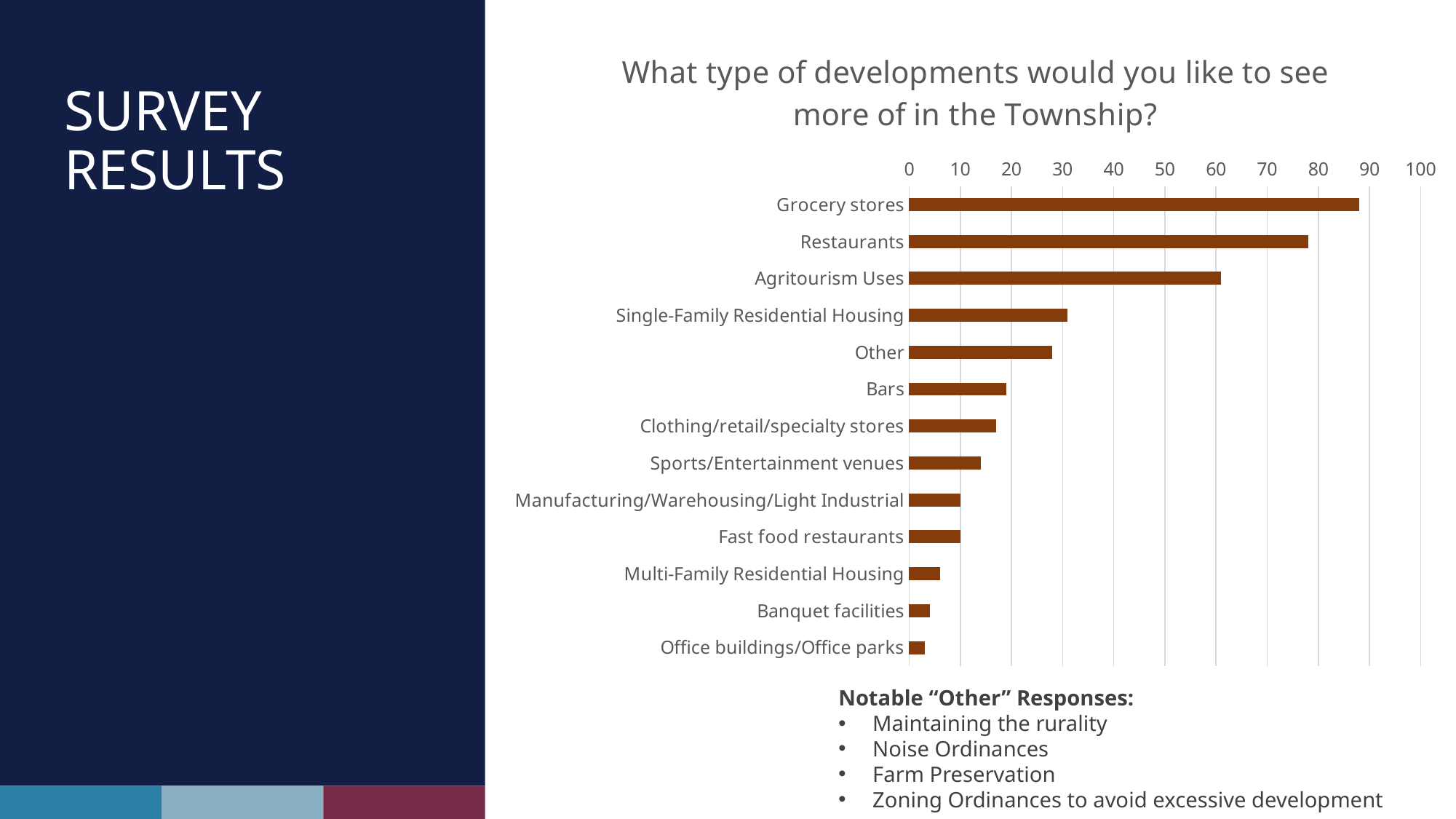
Which category has the highest value? Grocery stores Is the value for Agritourism Uses greater or less than 70? less What is the title of the chart? What type of developments would you like to see more of in the Township? How many categories are plotted in the chart? 13 Which category has the lowest value? Office buildings/Office parks Is the value for Restaurants greater or less than 70? greater Is the value for Grocery stores greater or less than 80? greater Which is larger, the value for Restaurants or the value for Agritourism Uses? Restaurants Which is larger, the value for Multi-Family Residential Housing or the value for Single-Family Residential Housing? Single-Family Residential Housing What type of chart is shown on the slide? Bar chart